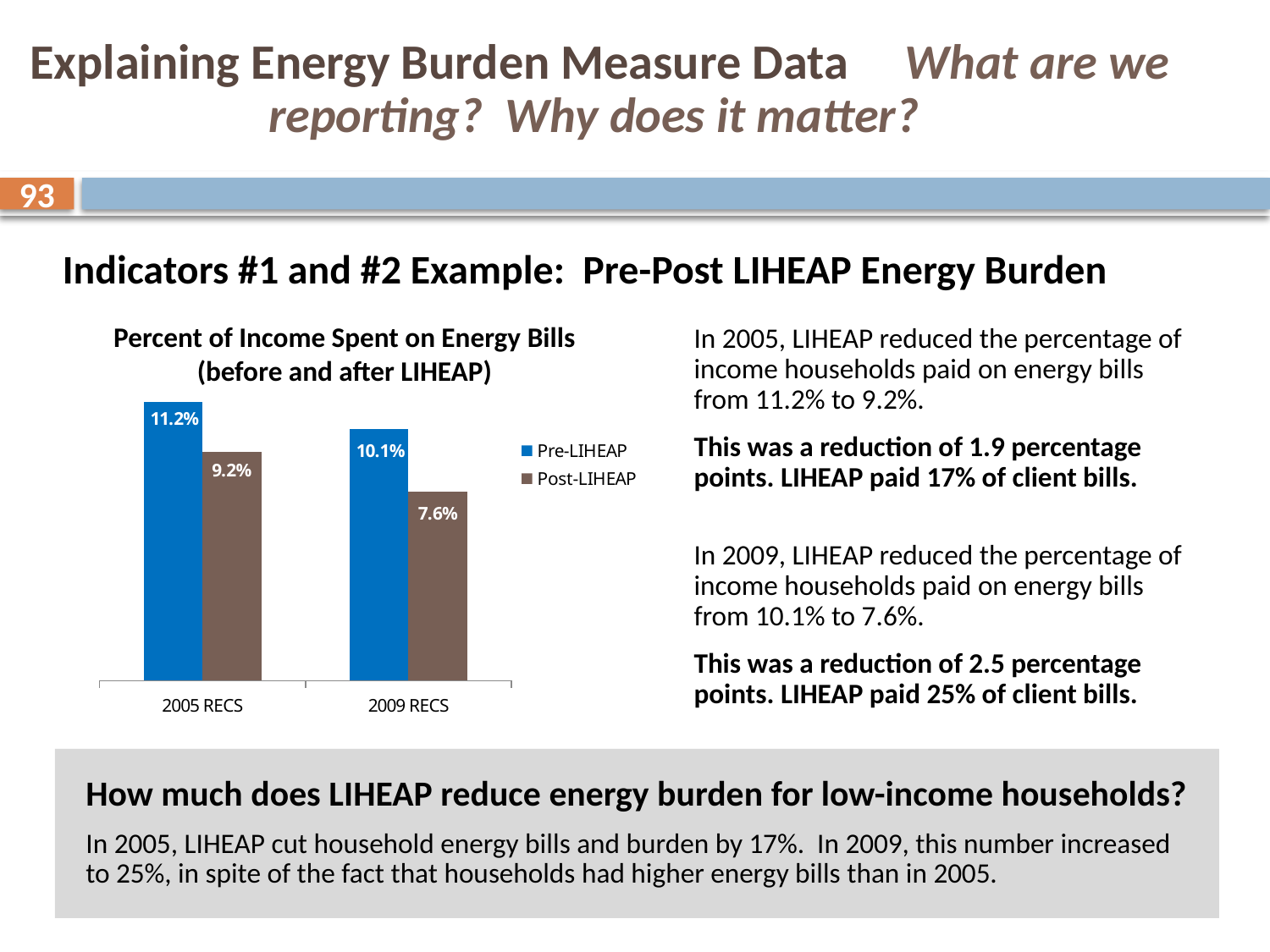
What is the Pre-LIHEAP value for 2009 RECS? 10.1% What is the title of the chart? Percent of Income Spent on Energy Bills (before and after LIHEAP) What is the Post-LIHEAP value for 2009 RECS? 7.6% Which bar in the chart has the lowest value? Post-LIHEAP for 2009 RECS Which is larger, the Post-LIHEAP value for 2005 RECS or the Post-LIHEAP value for 2009 RECS? 2005 RECS How many series does the chart legend list? 2 What is the difference between the Pre-LIHEAP and Post-LIHEAP values for 2009 RECS? 2.5 percentage points How many categories are shown on the x axis of the chart? 2 What is the Post-LIHEAP value for 2005 RECS? 9.2% What is the Pre-LIHEAP value for 2005 RECS? 11.2% What type of chart is shown on the slide? bar chart Which bar in the chart has the highest value? Pre-LIHEAP for 2005 RECS